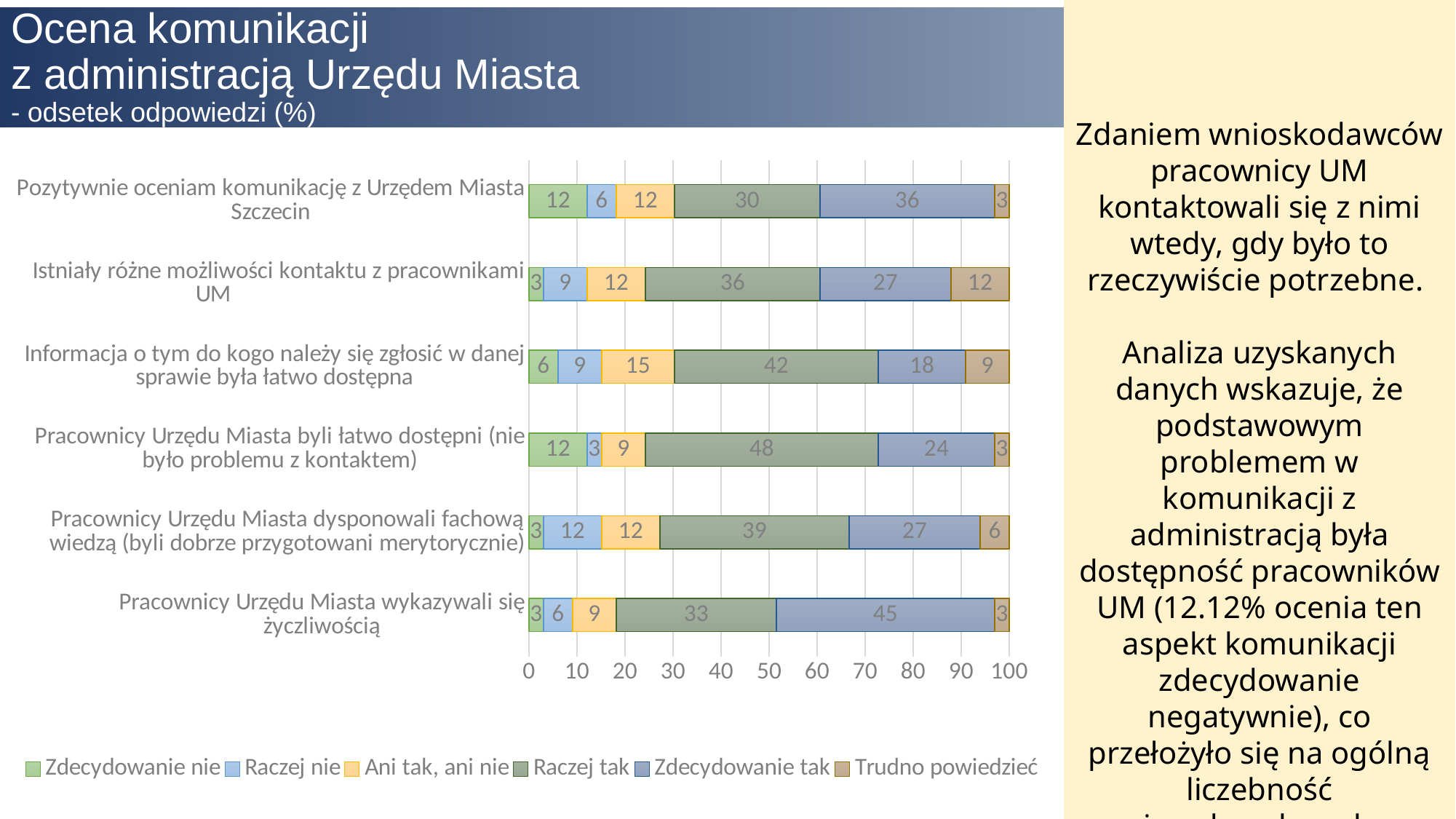
Which statement has the lowest 'Raczej tak' value? Pozytywnie oceniam komunikację z Urzędem Miasta Szczecin How many series does the legend list? 6 What is the value of 'Trudno powiedzieć' for 'Istniały różne możliwości kontaktu z pracownikami UM'? 12 Which legend entry is shown in green (the first segment of each bar)? Zdecydowanie nie Which statement has the highest 'Zdecydowanie tak' value? Pracownicy Urzędu Miasta wykazywali się życzliwością What is the difference between the 'Raczej tak' value for 'Informacja o tym do kogo należy się zgłosić w danej sprawie była łatwo dostępna' and the 'Raczej tak' value for 'Pozytywnie oceniam komunikację z Urzędem Miasta Szczecin'? 12 Which is larger: the 'Zdecydowanie nie' value for 'Pracownicy Urzędu Miasta byli łatwo dostępni (nie było problemu z kontaktem)' or for 'Pracownicy Urzędu Miasta dysponowali fachową wiedzą (byli dobrze przygotowani merytorycznie)'? Pracownicy Urzędu Miasta byli łatwo dostępni (nie było problemu z kontaktem) How many statements (categories) are plotted on the chart? 6 What is the value of 'Zdecydowanie tak' for 'Pracownicy Urzędu Miasta wykazywali się życzliwością'? 45 What type of chart is shown on the slide? Stacked bar chart What is the value of 'Raczej tak' for 'Pracownicy Urzędu Miasta byli łatwo dostępni (nie było problemu z kontaktem)'? 48 What is the total of the stacked bar for 'Informacja o tym do kogo należy się zgłosić w danej sprawie była łatwo dostępna'? 99